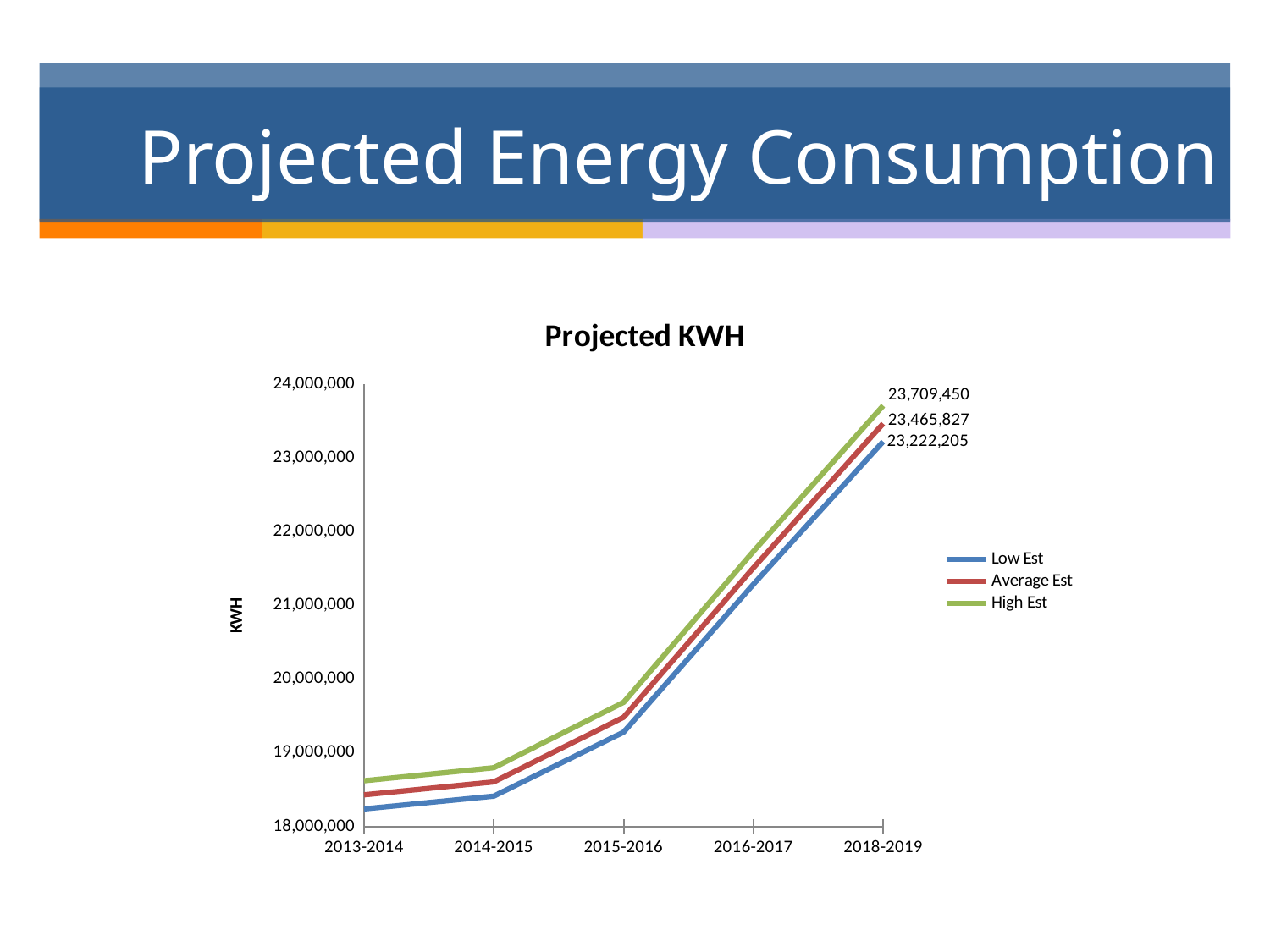
How many series does the legend list? 3 What is the High Est value for 2018-2019? 23,709,450 What is the difference between the Average Est and Low Est values for 2018-2019? 243,622 How many periods are shown on the x axis? 5 Is the Low Est value for 2013-2014 greater or less than 19,000,000? less What type of chart is shown on the slide? Line chart What is the Average Est value for 2018-2019? 23,465,827 Which series has the highest value in 2018-2019? High Est What is the Low Est value for 2018-2019? 23,222,205 What is the difference between the High Est and Low Est values for 2018-2019? 487,245 What is the title of the chart? Projected KWH Do the projected KWH values rise or fall from 2013-2014 to 2018-2019? Rise